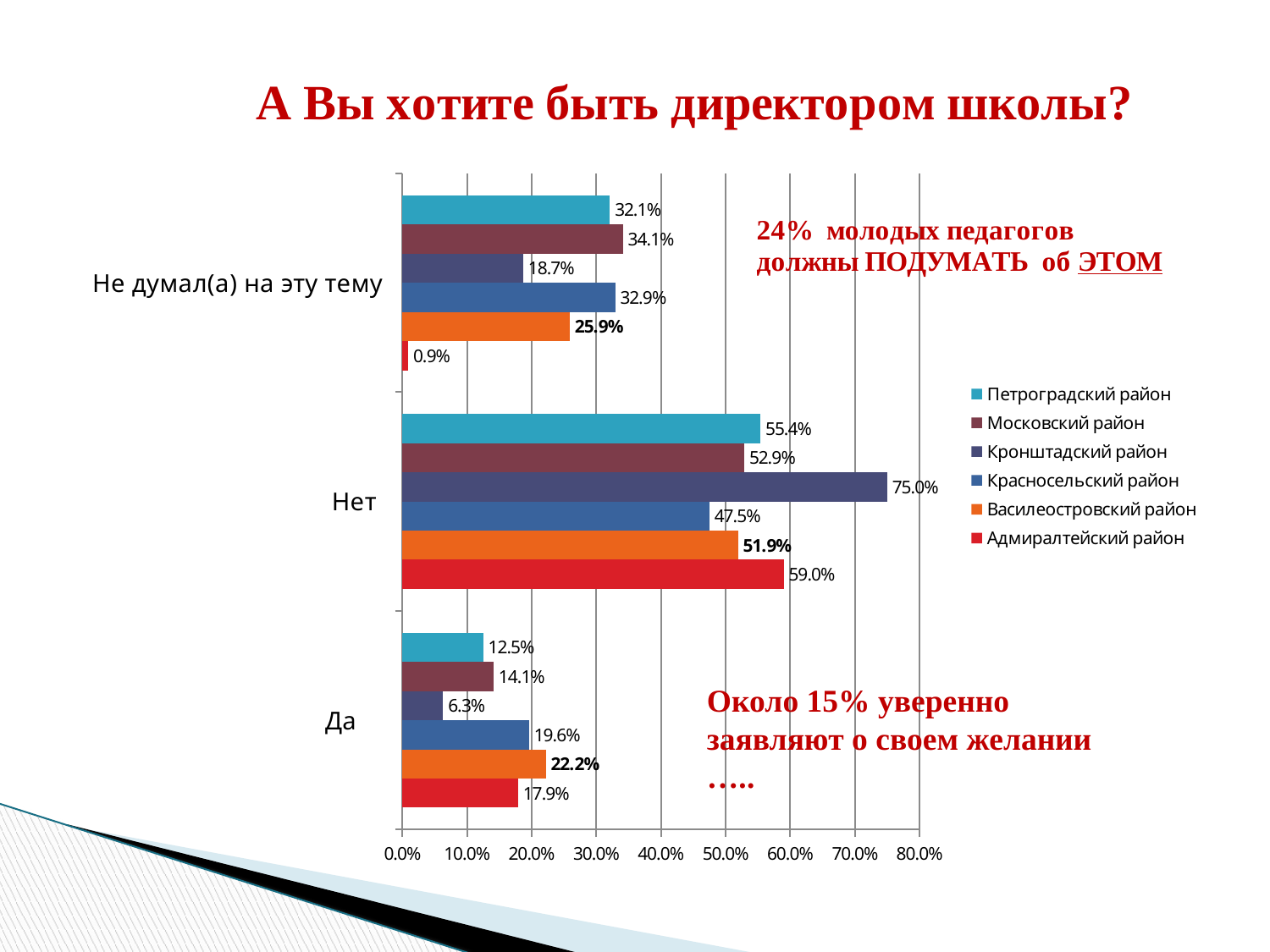
What is the value for Кронштадтский район in the "Нет" category? 75.0% What type of chart is shown on the slide? bar chart In the "Да" category, which is larger: Красносельский район or Московский район? Красносельский район What is the title of the slide above the chart? А Вы хотите быть директором школы? What is the value for Адмиралтейский район in the "Не думал(а) на эту тему" category? 0.9% Which district has the highest value in the "Нет" category? Кронштадтский район How many answer categories are shown on the vertical axis? 3 Is the value for Кронштадтский район in the "Нет" category greater or less than 70.0%? greater What is the difference between Адмиралтейский район and Петроградский район in the "Нет" category? 3.6% What is the value for Василеостровский район in the "Да" category? 22.2% How many series does the legend list? 6 Which district has the lowest value in the "Да" category? Кронштадтский район